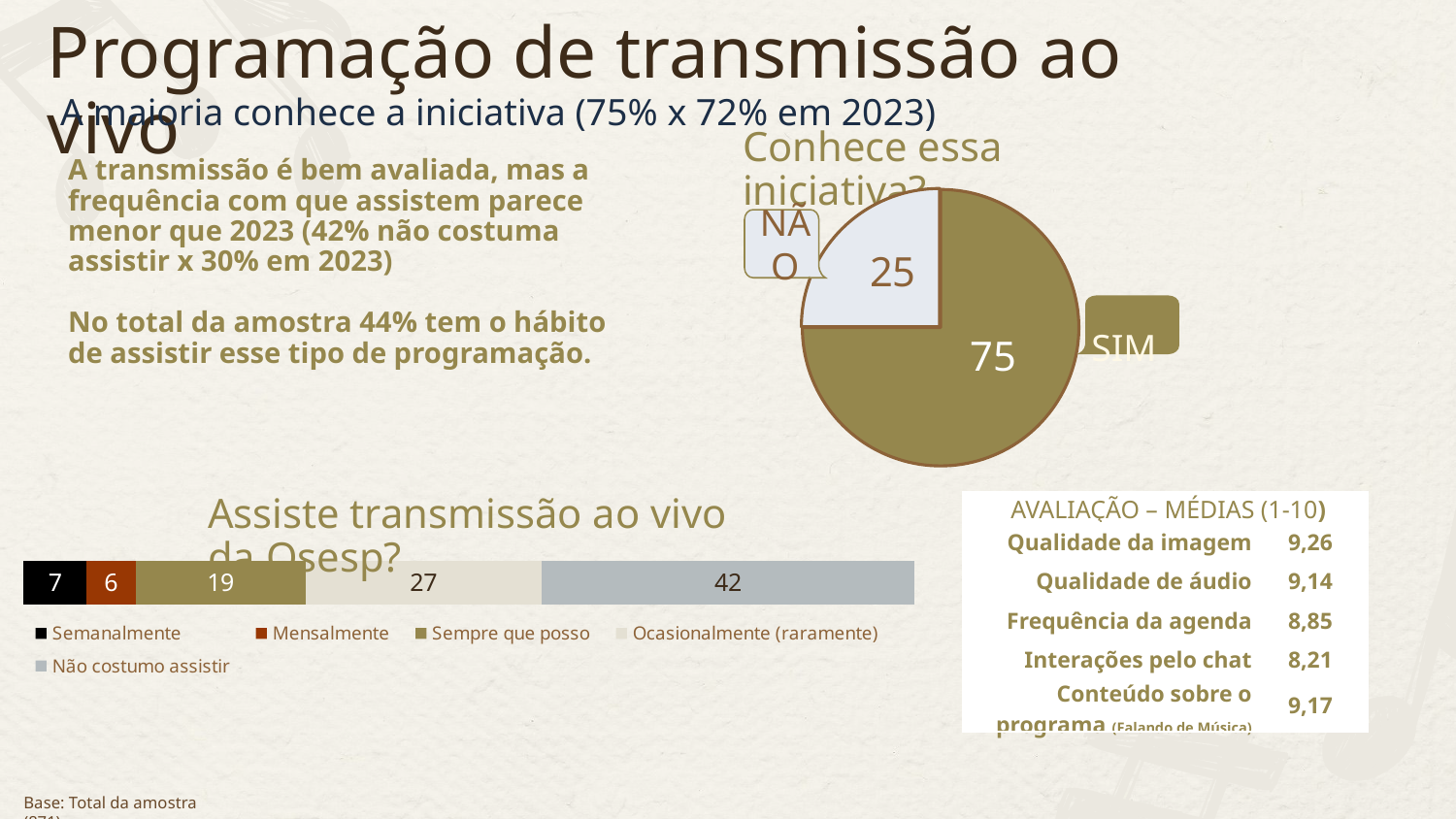
In the chart 'Assiste transmissão ao vivo da Osesp?', what is the difference between 'Ocasionalmente (raramente)' and 'Semanalmente'? 20 In the pie chart 'Conhece essa iniciativa?', how many slices are there? 2 In the pie chart 'Conhece essa iniciativa?', which slice is larger, SIM or NÃO? SIM In the chart 'Assiste transmissão ao vivo da Osesp?', what is the value for 'Sempre que posso'? 19 What kind of chart is 'Conhece essa iniciativa?'? pie chart In the chart 'Assiste transmissão ao vivo da Osesp?', how many series does the legend list? 5 In the chart 'Assiste transmissão ao vivo da Osesp?', which category has the lowest value? Mensalmente In the chart 'Assiste transmissão ao vivo da Osesp?', which category has the highest value? Não costumo assistir In the pie chart 'Conhece essa iniciativa?', what is the value for NÃO? 25 In the chart 'Assiste transmissão ao vivo da Osesp?', what is the value for 'Não costumo assistir'? 42 In the pie chart 'Conhece essa iniciativa?', what is the difference between the SIM and NÃO values? 50 In the pie chart 'Conhece essa iniciativa?', what is the value for SIM? 75